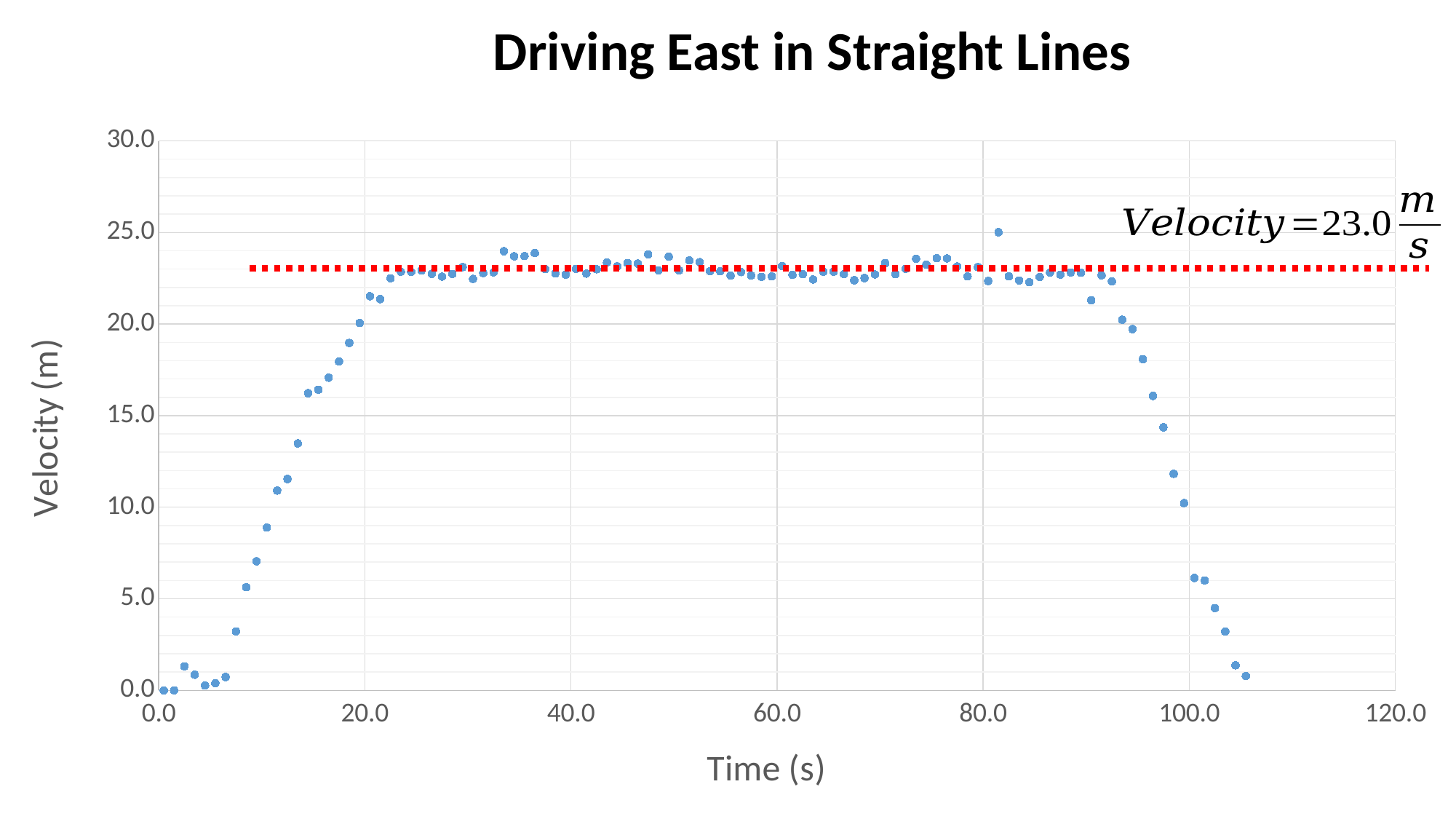
What velocity value does the red dotted horizontal line represent, according to the annotation? 23.0 m/s Do the plotted velocities rise or fall between 0.0 s and 20.0 s? rise Is the velocity at a time of 40.0 s greater or less than 20.0? greater What kind of chart is shown on the slide? Scatter chart What is the title of the chart? Driving East in Straight Lines Is the velocity at a time of 60.0 s greater or less than 25.0? less Which is larger, the velocity at 40.0 s or the velocity at 100.0 s? the velocity at 40.0 s Do the plotted velocities rise or fall between 95.0 s and 105.0 s? fall What is the maximum value shown on the y axis? 30.0 Is the velocity at a time of 10.0 s greater or less than 10.0? less What is the label of the x axis? Time (s)